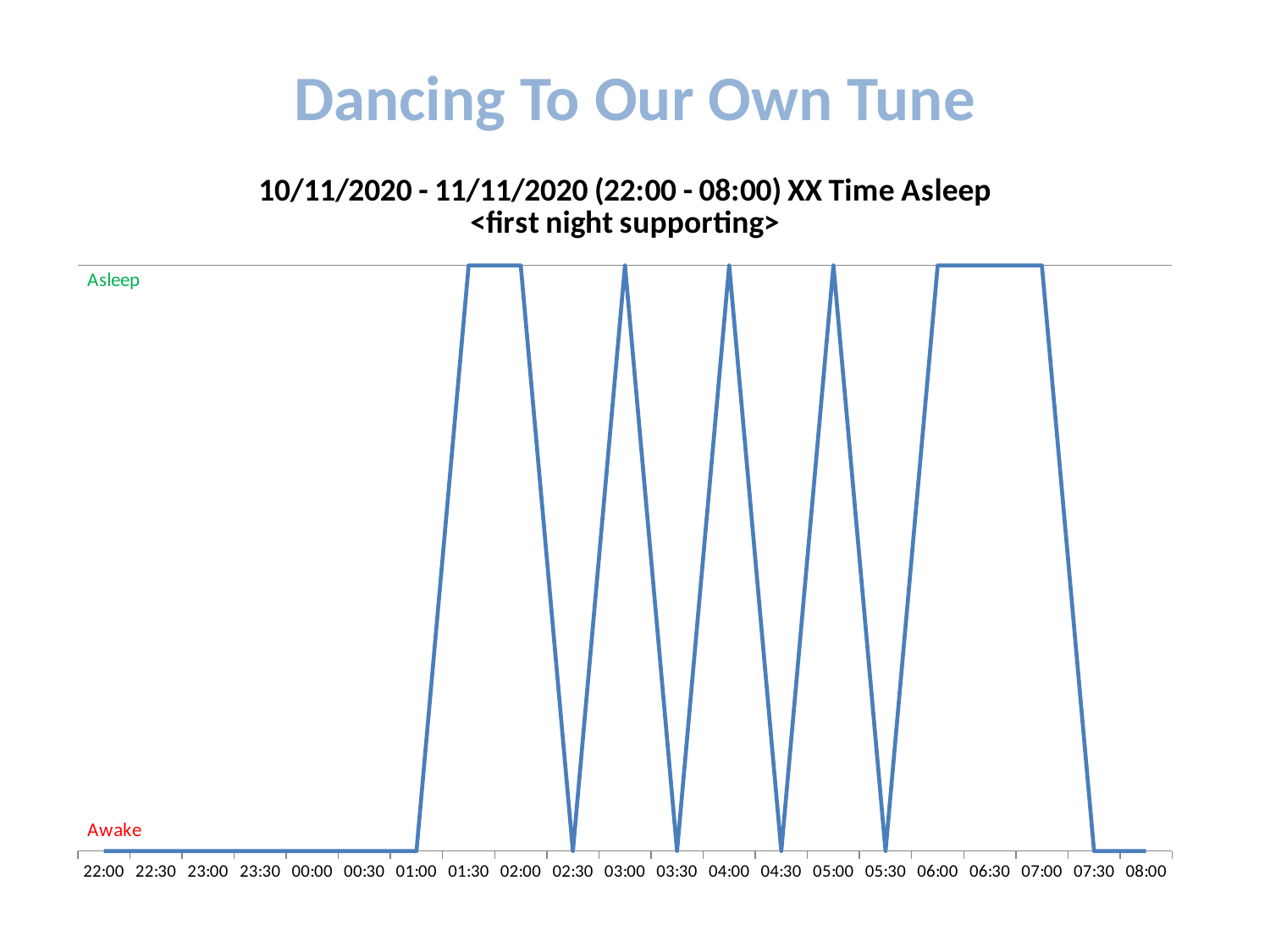
What is the state shown at 02:30? Awake What is the state shown at 04:00? Asleep What are the two labels shown on the vertical axis? Asleep and Awake What is the chart's title? 10/11/2020 - 11/11/2020 (22:00 - 08:00) XX Time Asleep <first night supporting> What is the state shown at 22:00? Awake How many lines (series) are plotted on the chart? 1 What is the state shown at 06:30? Asleep What is the state shown at 01:30? Asleep What kind of chart is shown on the slide? Line chart How many time labels are shown along the x axis? 21 What is the state shown at 07:30? Awake At what time does the line first reach the Asleep level? 01:30